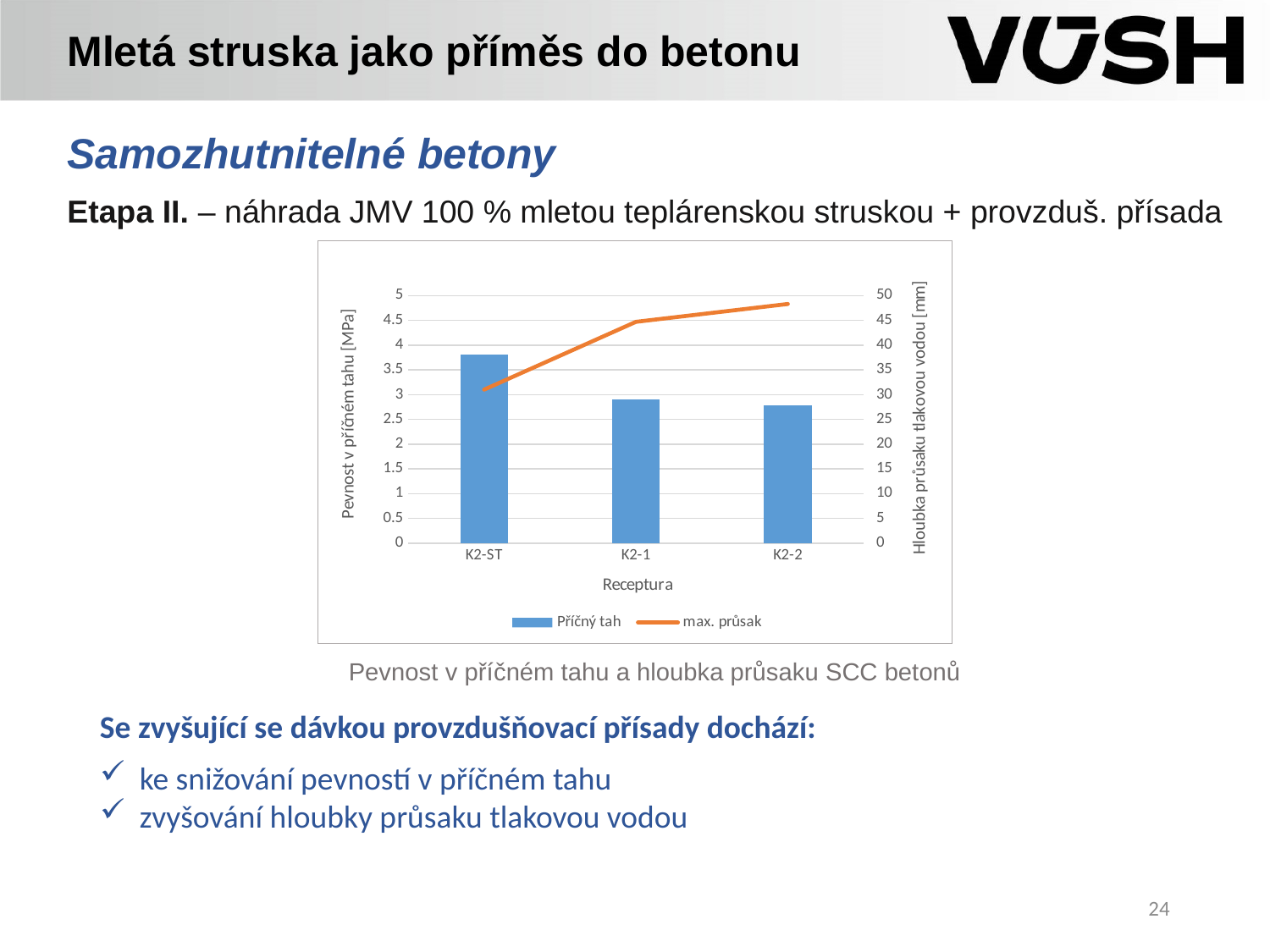
Is the Příčný tah value for K2-2 greater or less than 3 MPa? less What kind of chart is shown on the slide? a combined bar and line chart Is the Příčný tah value for K2-ST greater or less than 3.5 MPa? greater How many recipes (categories) are shown on the x axis of the chart? 3 Which recipe has the highest Příčný tah (bar) value? K2-ST Which recipe has the lowest max. průsak (line) value? K2-ST Is the max. průsak value for K2-1 greater or less than 40 mm? greater How many series does the chart legend list? 2 What is the label of the x axis of the chart? Receptura Which recipe has the highest max. průsak (line) value? K2-2 Does the max. průsak line rise or fall from K2-ST to K2-2? rises